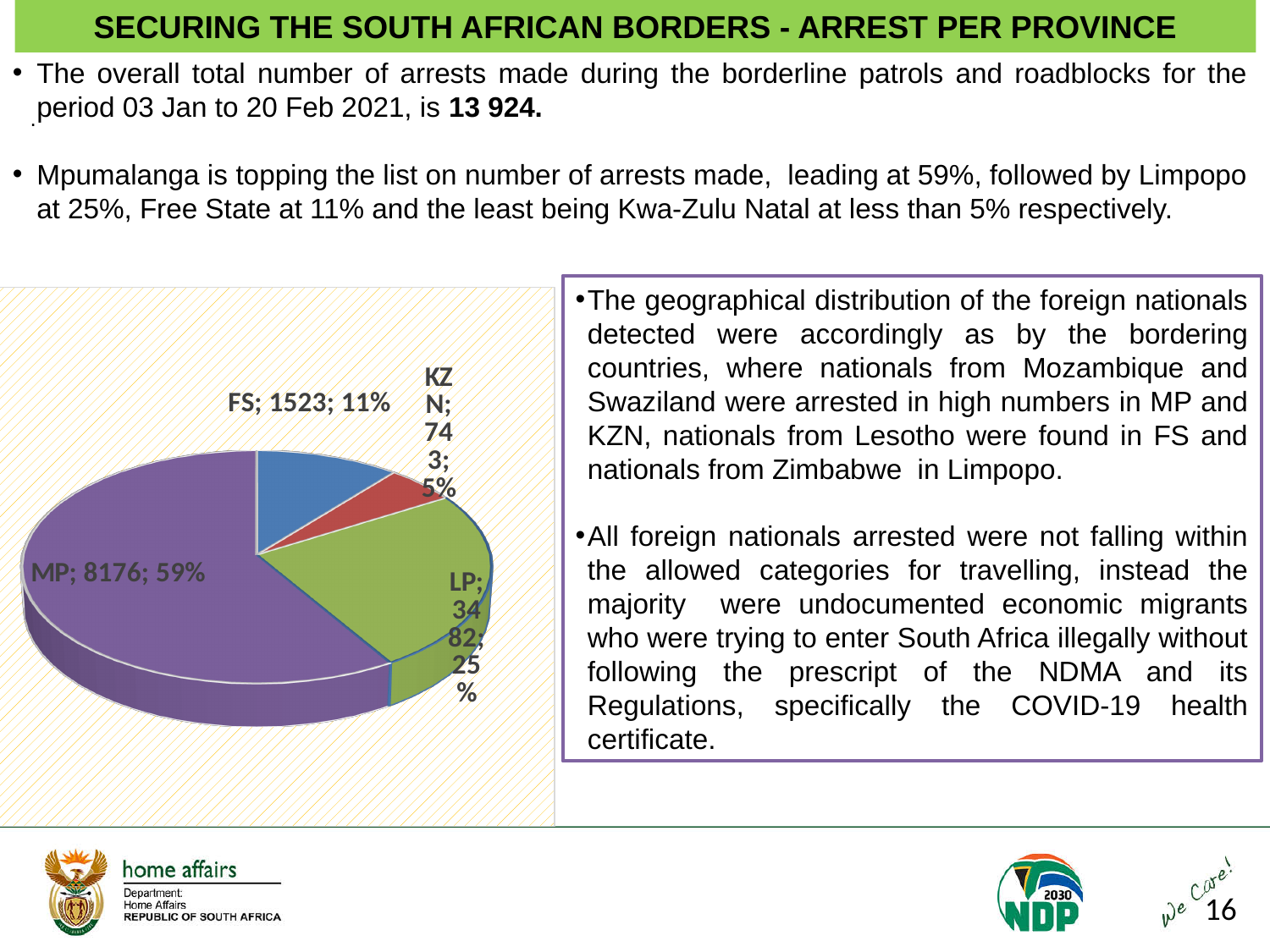
Which province has the largest slice in the pie chart? MP What is the number of arrests shown for FS in the pie chart? 1523 What share of the pie does FS account for? 11% What is the difference between the arrests for MP and LP in the pie chart? 4694 What is the number of arrests shown for MP in the pie chart? 8176 What share of the pie does LP account for? 25% What kind of chart is shown on the slide? pie chart Which has more arrests in the pie chart, FS or KZN? FS What is the number of arrests shown for LP in the pie chart? 3482 What is the number of arrests shown for KZN in the pie chart? 743 Which province has the smallest slice in the pie chart? KZN How many provinces are shown as slices in the pie chart? 4